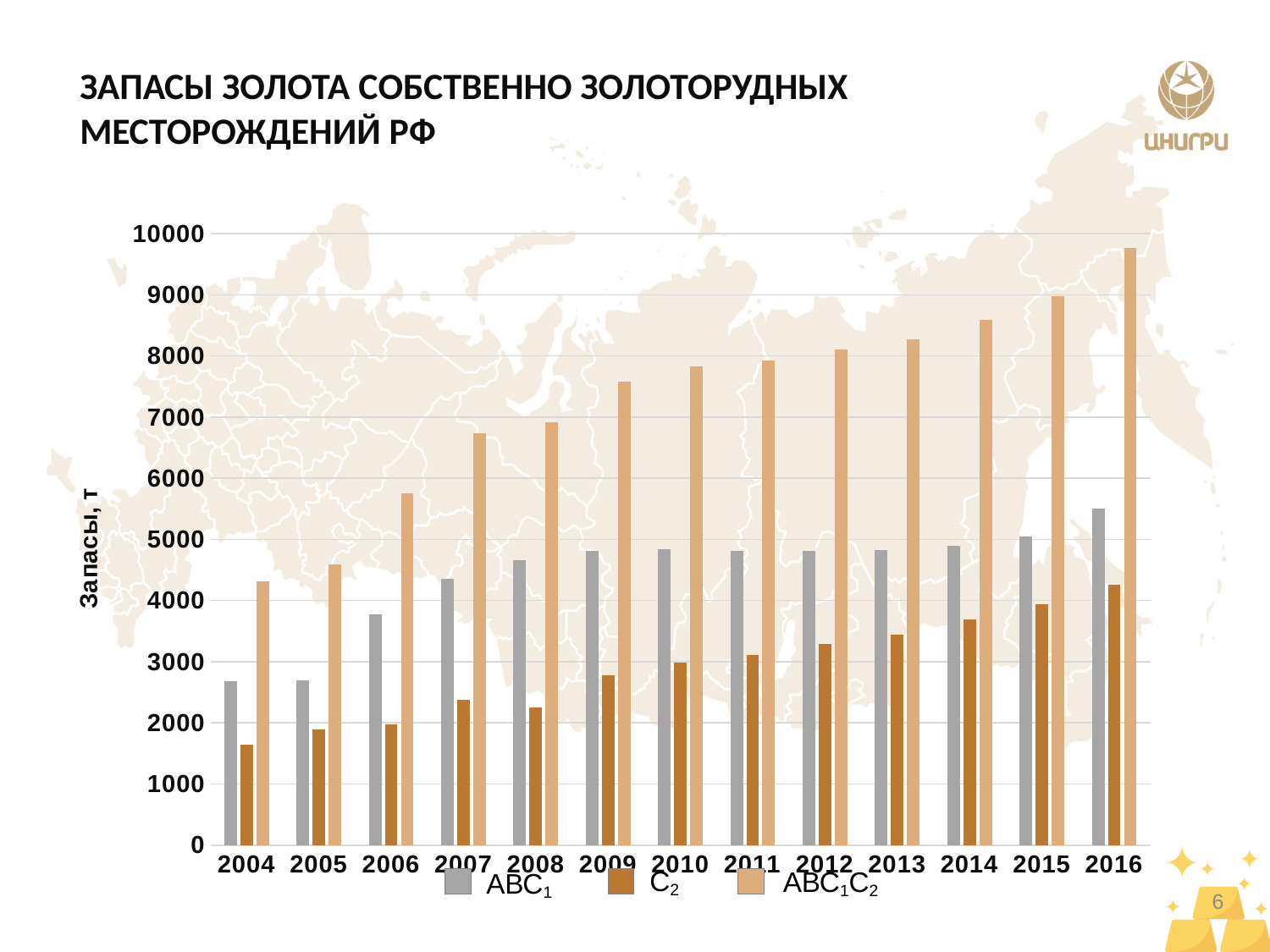
Which is larger in 2016, the ABC1 value or the C2 value? ABC1 How many years are shown on the x axis of the chart? 13 Is the ABC1 value for 2006 greater or less than 4000? less What kind of chart is shown on the slide? bar chart How many series does the legend list? 3 What is the label of the vertical axis? Запасы, т Do the ABC1C2 values rise or fall from 2004 to 2016? rise In which year is the C2 value lowest? 2004 Is the ABC1 value for 2016 greater or less than 5000? greater Is the ABC1C2 value for 2016 greater or less than 9000? greater In which year is the ABC1C2 value highest? 2016